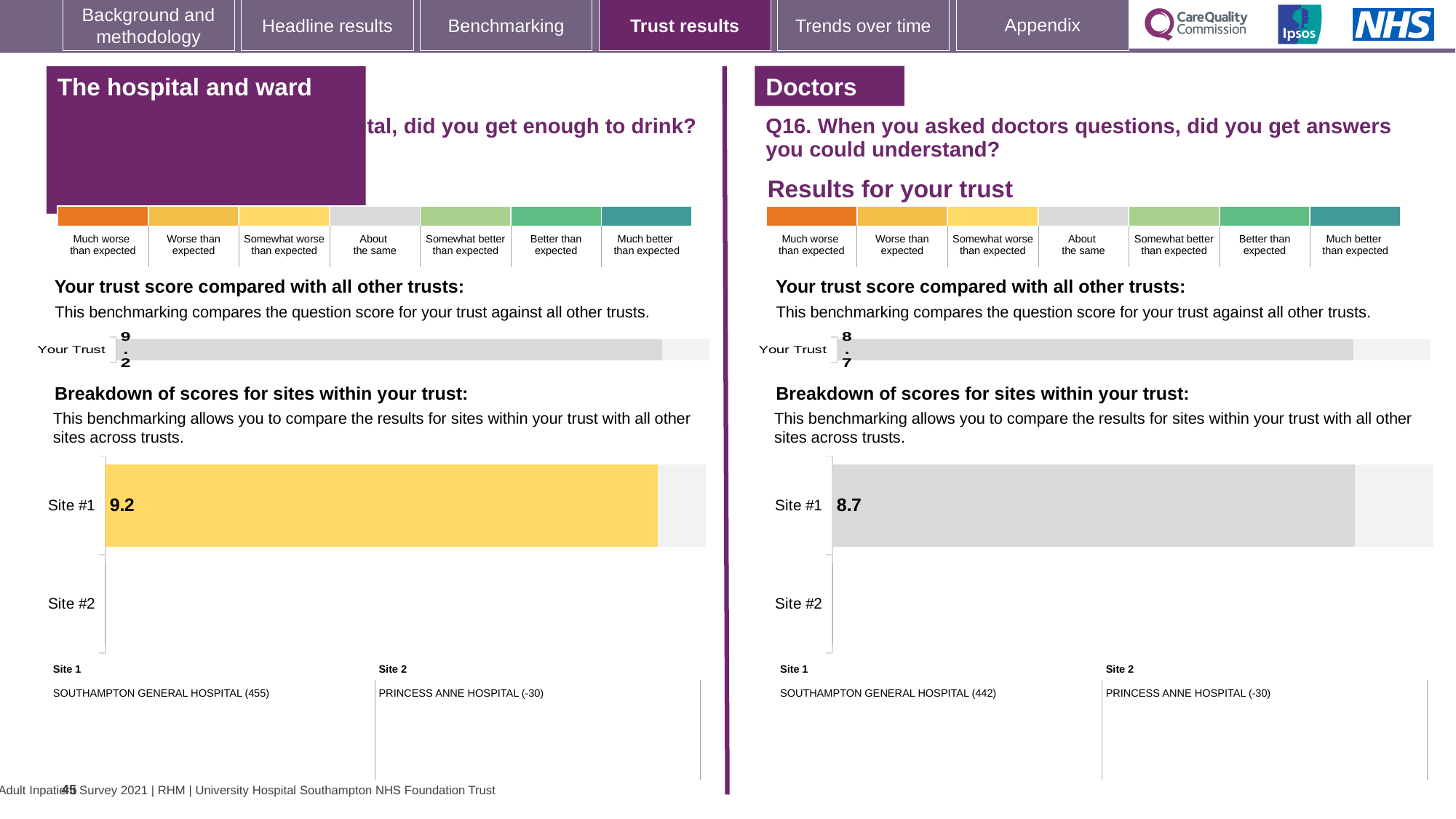
On the right-hand breakdown chart (Q16, Doctors), what colour is the Site #1 bar? Grey What type of chart is used for the 'Breakdown of scores for sites within your trust' on the right-hand side? Bar chart Which hospital is listed as Site 1 under the right-hand breakdown chart (Q16, Doctors)? SOUTHAMPTON GENERAL HOSPITAL (442) On the right-hand 'Breakdown of scores for sites within your trust' chart (Q16, Doctors), what is the score for Site #1? 8.7 Which hospital is listed as Site 2 under the left-hand breakdown chart? PRINCESS ANNE HOSPITAL (-30) On the right-hand 'Your trust score compared with all other trusts' chart (Q16, Doctors), what is the value shown for Your Trust? 8.7 Which is larger: the Your Trust score on the left-hand chart or the Your Trust score on the right-hand chart (Q16, Doctors)? The left-hand chart (9.2) What is the difference between the Site #1 score on the left-hand breakdown chart and the Site #1 score on the right-hand breakdown chart? 0.5 On the left-hand 'Breakdown of scores for sites within your trust' chart, what is the score for Site #1? 9.2 How many site categories are listed on the left-hand 'Breakdown of scores for sites within your trust' chart? 2 On the left-hand 'Your trust score compared with all other trusts' chart, what is the value shown for Your Trust? 9.2 On the left-hand breakdown chart, which site has a bar plotted? Site #1